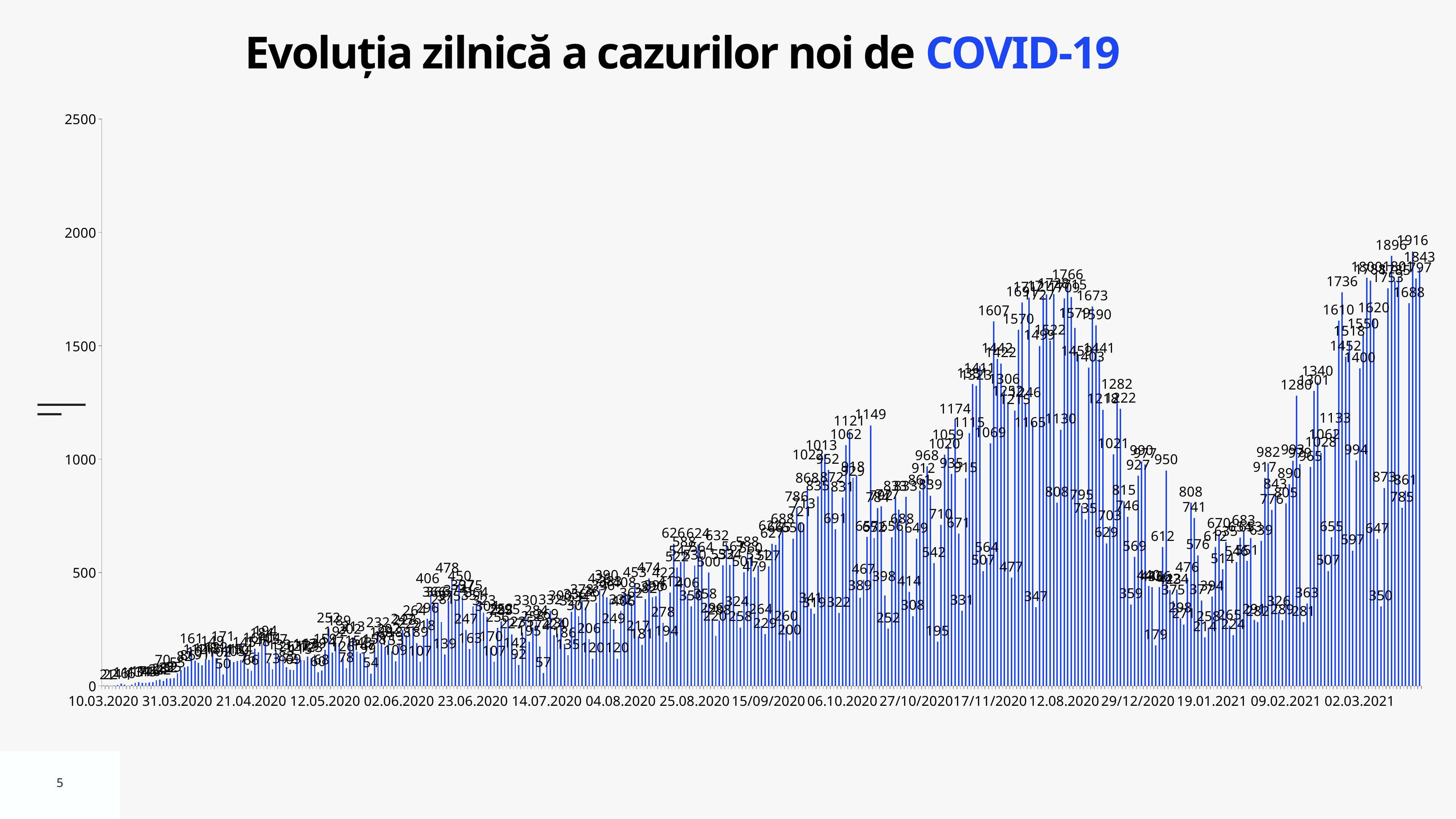
What is the title of the chart? Evoluția zilnică a cazurilor noi de COVID-19 What is the last date label on the horizontal axis? 02.03.2021 What kind of chart is shown on the slide? bar chart Is the value at the 02.03.2021 tick greater or less than 1500? less Overall, do the daily case values rise or fall from the left of the chart to the right? rise What is the difference between the two highest labeled values, 1916 and 1896? 20 What is the maximum value shown on the vertical axis? 2500 Which is larger: the peak labeled 1766 near 12.08.2020 or the peak labeled 1916 near 02.03.2021? 1916 near 02.03.2021 Is the highest bar on the chart greater or less than 2000? less What is the first date label on the horizontal axis? 10.03.2020 What is the highest value labeled on the chart? 1916 Is the value at the 12.05.2020 tick greater or less than 500? less